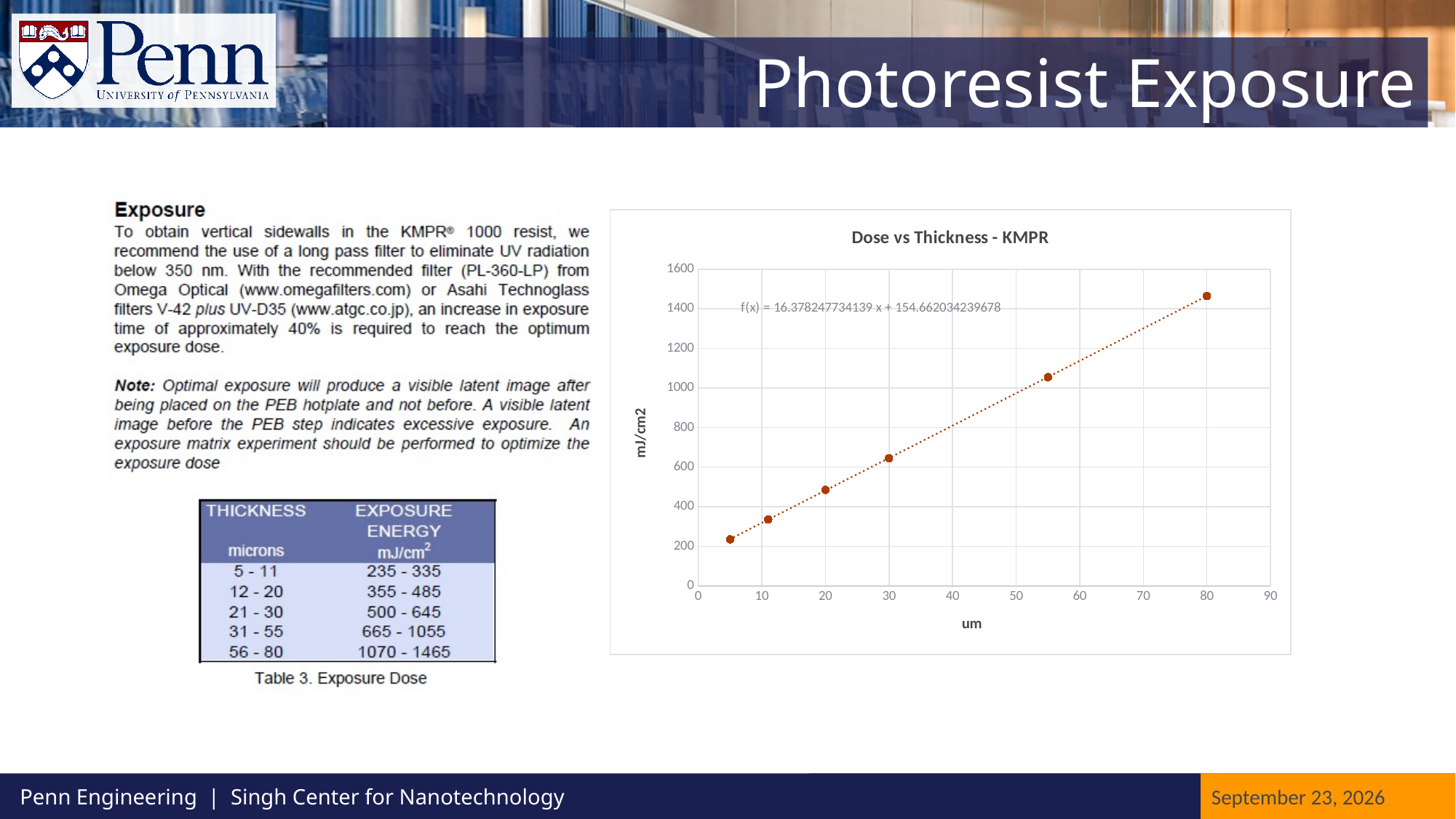
At which thickness (um) is the plotted dose lowest? 5 Do the plotted values rise or fall as thickness (um) increases? rise What is the title of the chart? Dose vs Thickness - KMPR What kind of chart is shown on the slide? scatter chart Is the value for the point at 55 um greater or less than 1000 mJ/cm2? greater Is the value for the point at 80 um greater or less than 1400 mJ/cm2? greater What is the label on the y axis of the chart? mJ/cm2 How many data points are plotted in the chart? 6 At which thickness (um) is the plotted dose highest? 80 Is the value for the point at 30 um greater or less than 600 mJ/cm2? greater Which has the larger dose value, the point at 55 um or the point at 30 um? 55 um